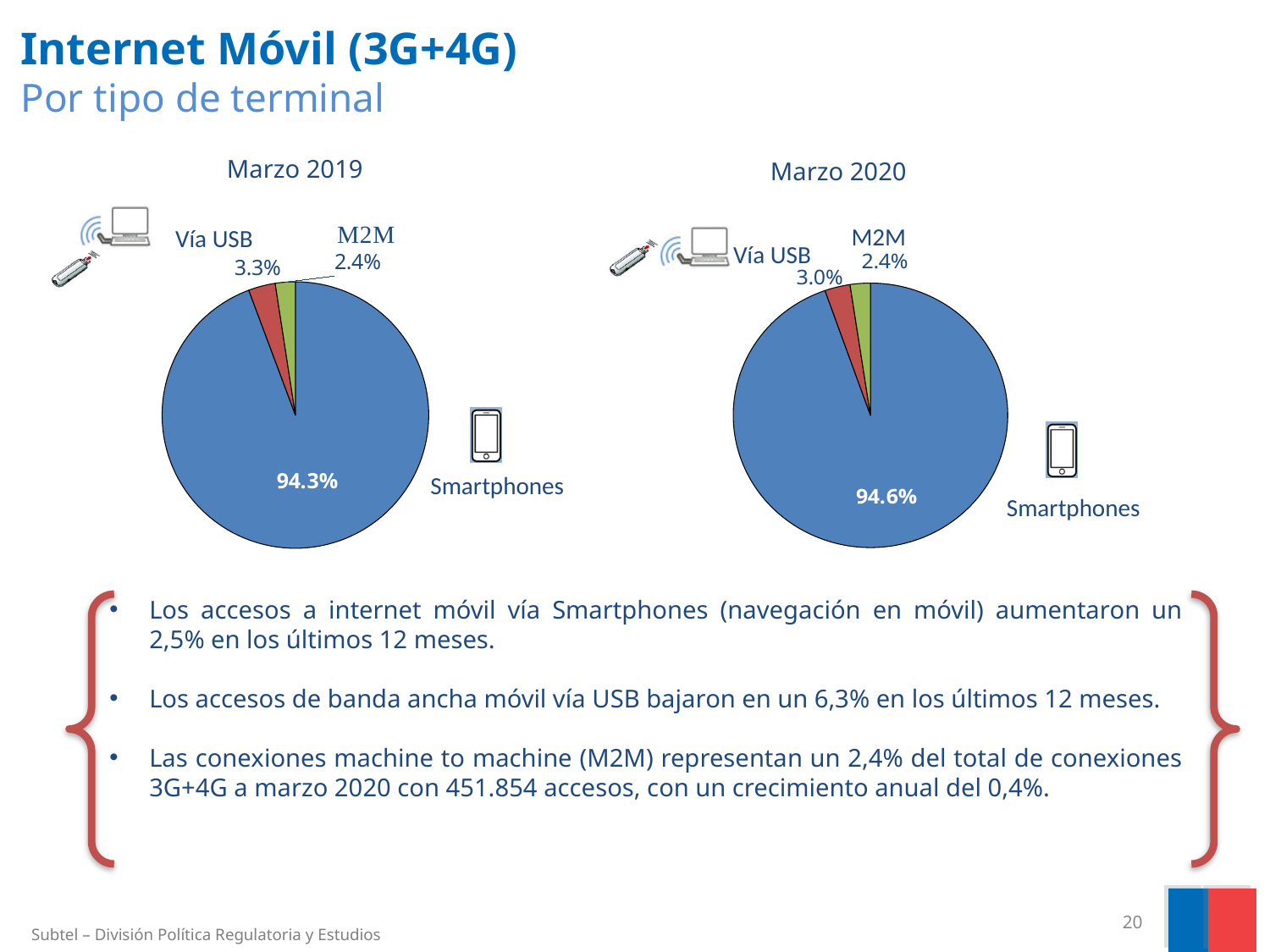
What type of chart is used for Marzo 2019? Pie chart In the Marzo 2020 pie chart, which category has the smallest slice? M2M How many categories does the Marzo 2020 pie chart show? 3 In the Marzo 2019 pie chart, which is larger, Vía USB or M2M? Vía USB In the Marzo 2020 pie chart, what is the value for Vía USB? 3.0% In the Marzo 2020 pie chart, what is the value for M2M? 2.4% In the Marzo 2020 pie chart, what share do Smartphones have? 94.6% In the Marzo 2020 pie chart, what colour is the Smartphones slice? Blue In the Marzo 2019 pie chart, what is the value for Vía USB? 3.3% In the Marzo 2019 pie chart, which category has the largest slice? Smartphones In the Marzo 2019 pie chart, what share do Smartphones have? 94.3% In the Marzo 2019 pie chart, what is the difference between the Vía USB and M2M shares? 0.9%